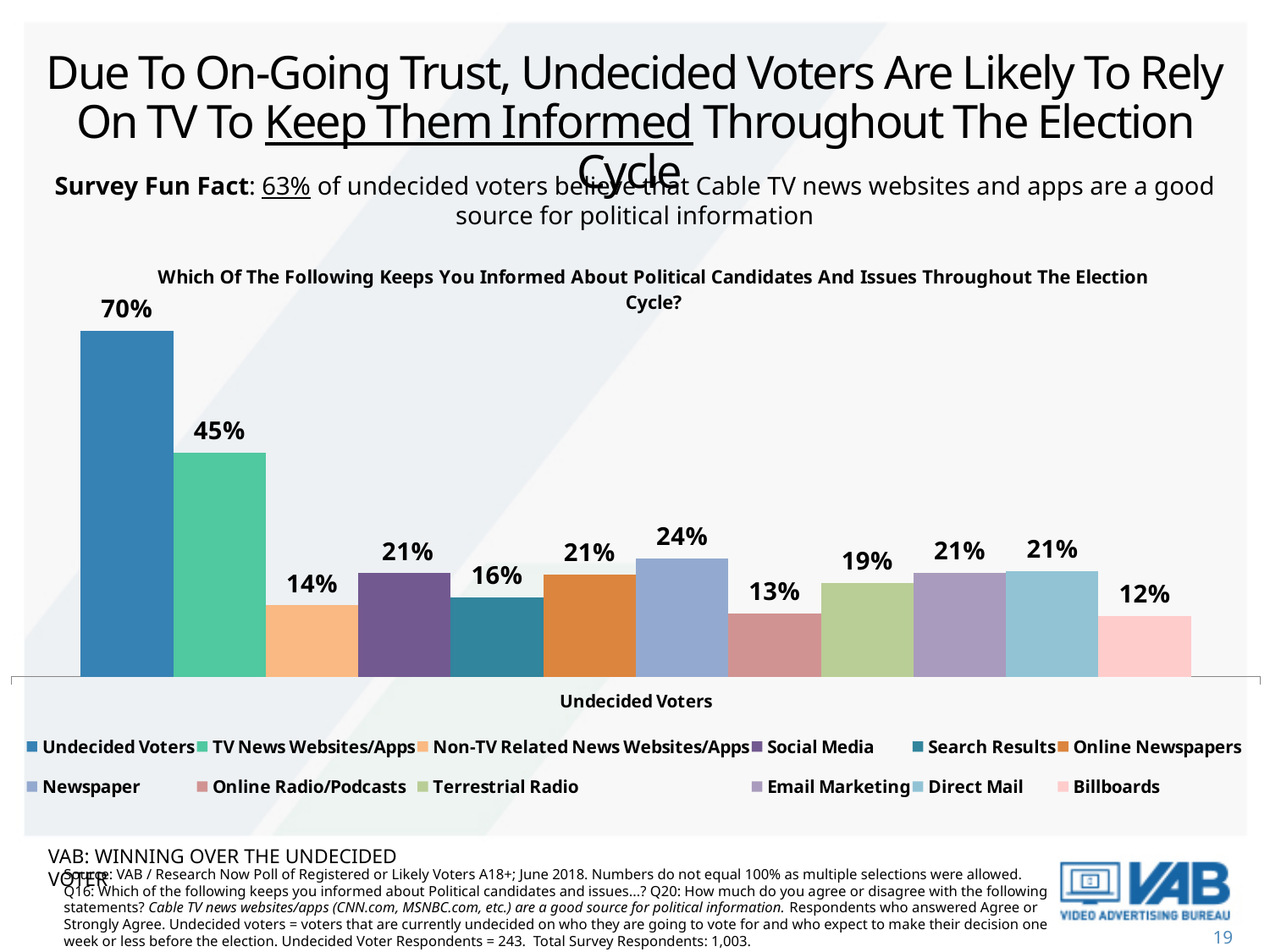
What value is shown for Terrestrial Radio? 19% What value is shown for Billboards? 12% What is the difference between the values for TV News Websites/Apps and Newspaper? 21% What value is shown for Search Results? 16% What value is shown for TV News Websites/Apps? 45% What is the title of the chart? Which Of The Following Keeps You Informed About Political Candidates And Issues Throughout The Election Cycle? Which series has the lowest value? Billboards What value is shown for Newspaper? 24% What kind of chart is shown on the slide? Bar chart How many series does the legend list? 12 What is the difference between the values for Non-TV Related News Websites/Apps and Billboards? 2% Which is larger, the value for Social Media or the value for Online Radio/Podcasts? Social Media